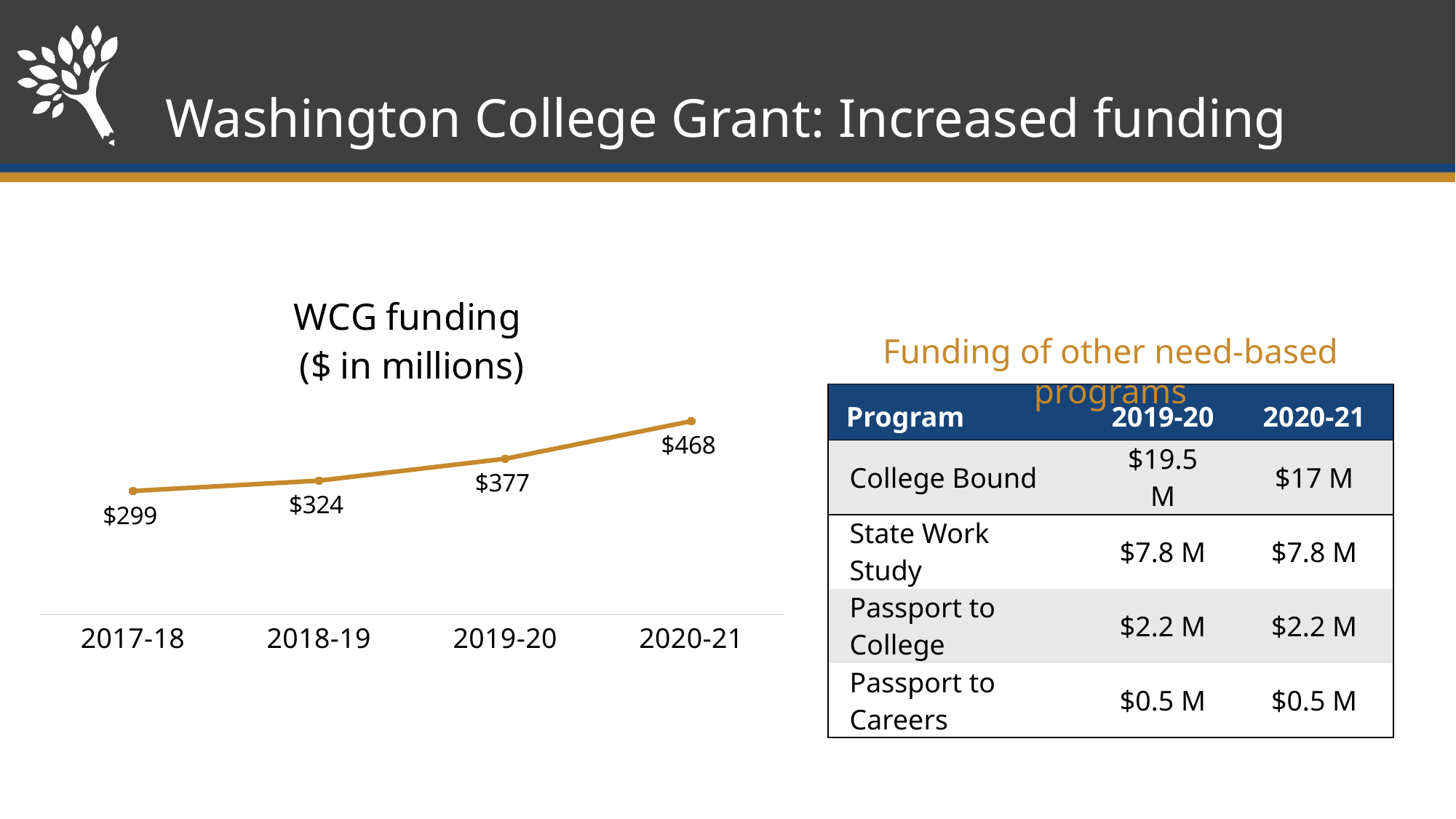
How many years are plotted in the WCG funding chart? 4 What is the WCG funding value for 2017-18? $299 What is the WCG funding value for 2019-20? $377 Which year has higher WCG funding, 2018-19 or 2019-20? 2019-20 What is the WCG funding value for 2018-19? $324 Which year has the highest WCG funding? 2020-21 What is the WCG funding value for 2020-21? $468 What is the difference in WCG funding between 2020-21 and 2017-18? $169 Does WCG funding rise or fall from 2017-18 to 2020-21? rise Which year has the lowest WCG funding? 2017-18 What is the difference in WCG funding between 2019-20 and 2018-19? $53 What kind of chart is the WCG funding chart? line chart